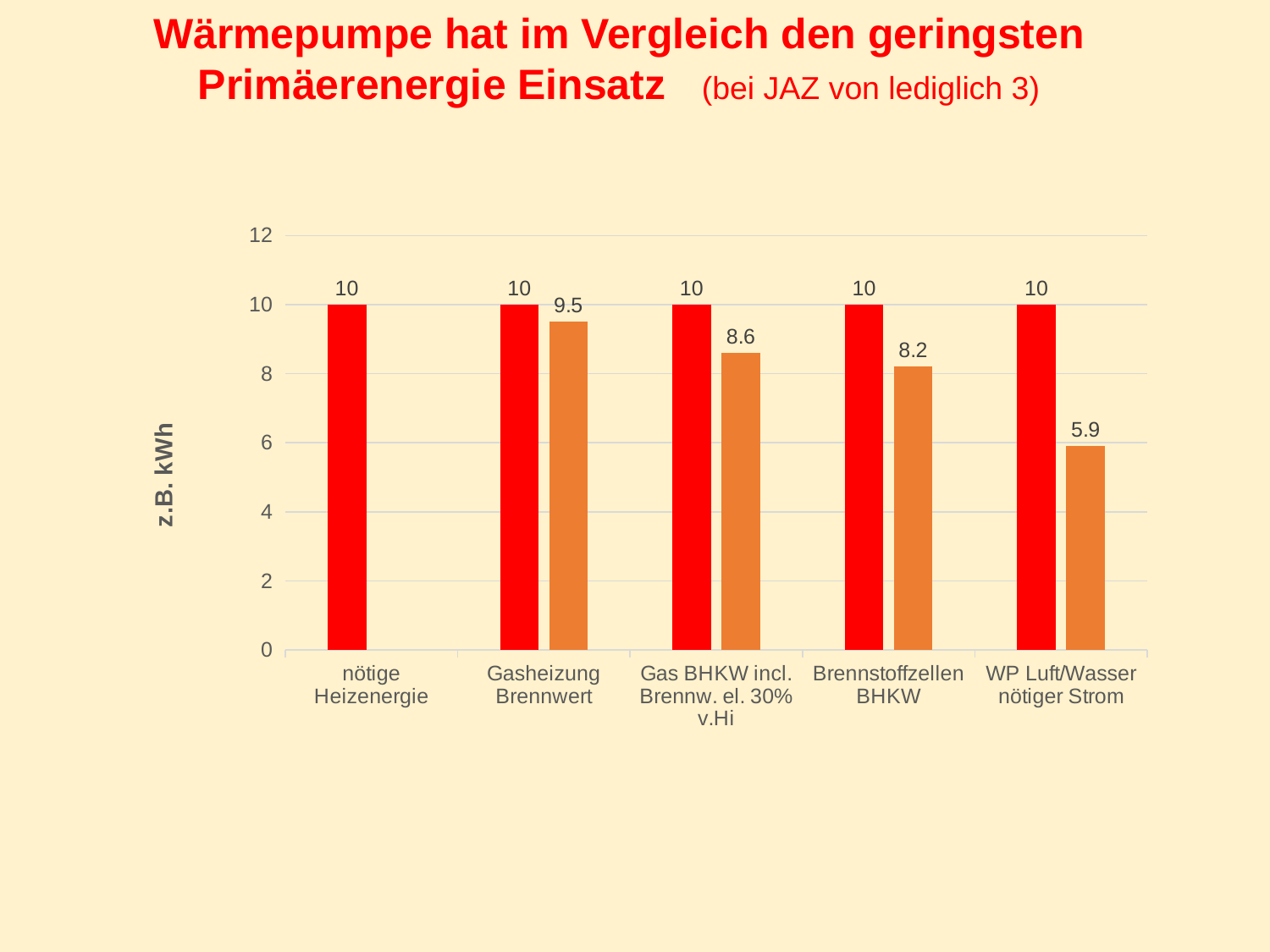
What is the value of the orange bar for Brennstoffzellen BHKW? 8.2 How many categories are shown on the x axis? 5 What is the value of the orange bar for Gasheizung Brennwert? 9.5 Which category has the lowest orange bar? WP Luft/Wasser nötiger Strom What is the difference between the orange bar for Gasheizung Brennwert and the orange bar for WP Luft/Wasser nötiger Strom? 3.6 What is the label of the y axis? z.B. kWh What is the value of the red bar for nötige Heizenergie? 10 What kind of chart is shown on the slide? Bar chart Which category has the highest orange bar? Gasheizung Brennwert Which is larger: the orange bar for Gas BHKW incl. Brennw. el. 30% v.Hi or the orange bar for Brennstoffzellen BHKW? Gas BHKW incl. Brennw. el. 30% v.Hi What is the value of the orange bar for WP Luft/Wasser nötiger Strom? 5.9 What is the value of the orange bar for Gas BHKW incl. Brennw. el. 30% v.Hi? 8.6